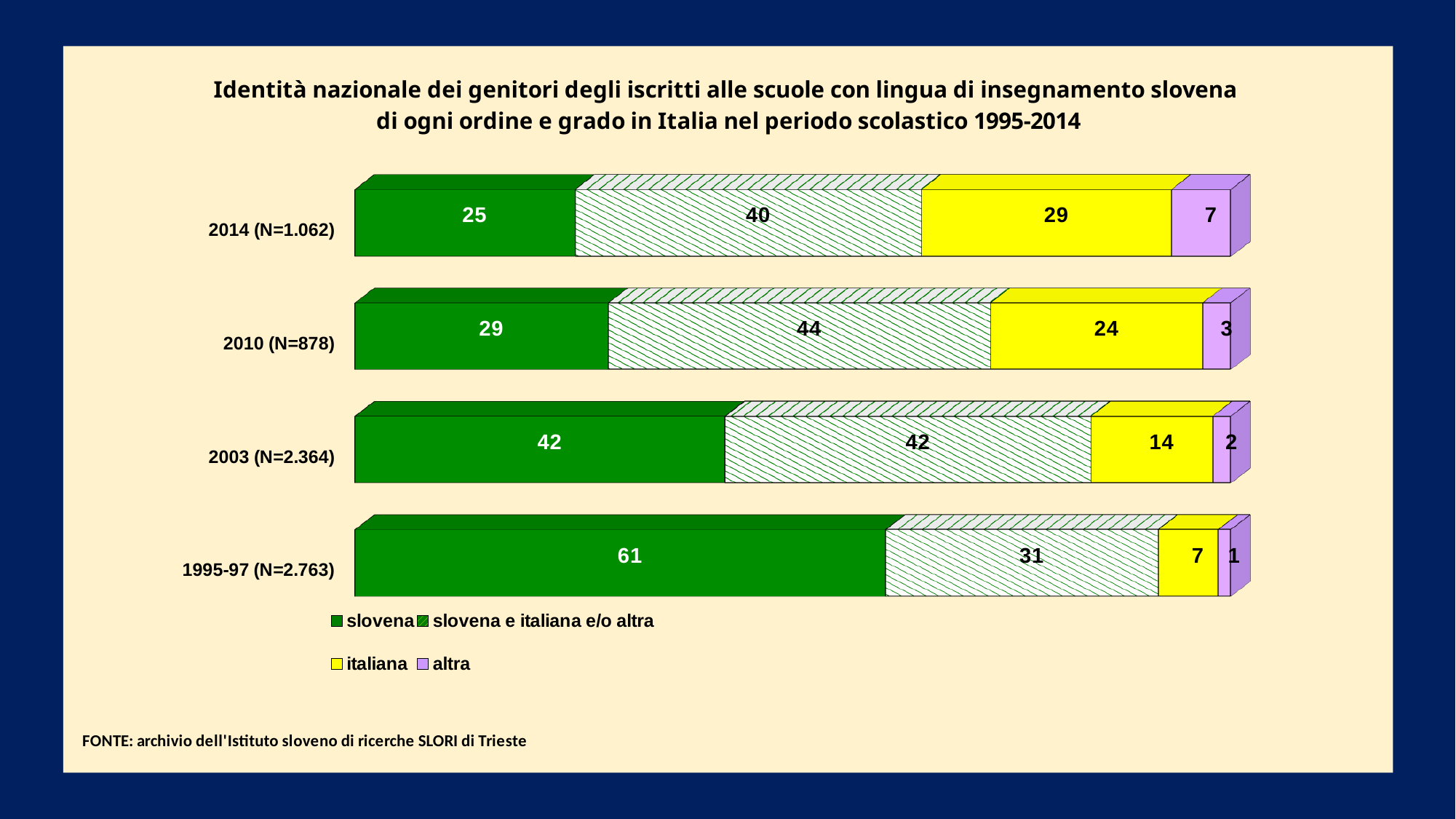
Which period has the lowest value for 'italiana'? 1995-97 (N=2.763) What is the value for 'slovena' in 2014 (N=1.062)? 25 What is the value for 'slovena e italiana e/o altra' in 2010 (N=878)? 44 What is the total of the stacked bar for 2010 (N=878)? 100 What is the value for 'altra' in 1995-97 (N=2.763)? 1 What is the value for 'italiana' in 2003 (N=2.364)? 14 How many series does the legend list? 4 How many periods (bars) are shown in the chart? 4 Which period has the highest value for 'slovena'? 1995-97 (N=2.763) What is the difference between the 'slovena' values for 1995-97 (N=2.763) and 2014 (N=1.062)? 36 What kind of chart is shown on the slide? Stacked bar chart Which is larger: the 'italiana' value in 2014 (N=1.062) or in 2010 (N=878)? 2014 (N=1.062)